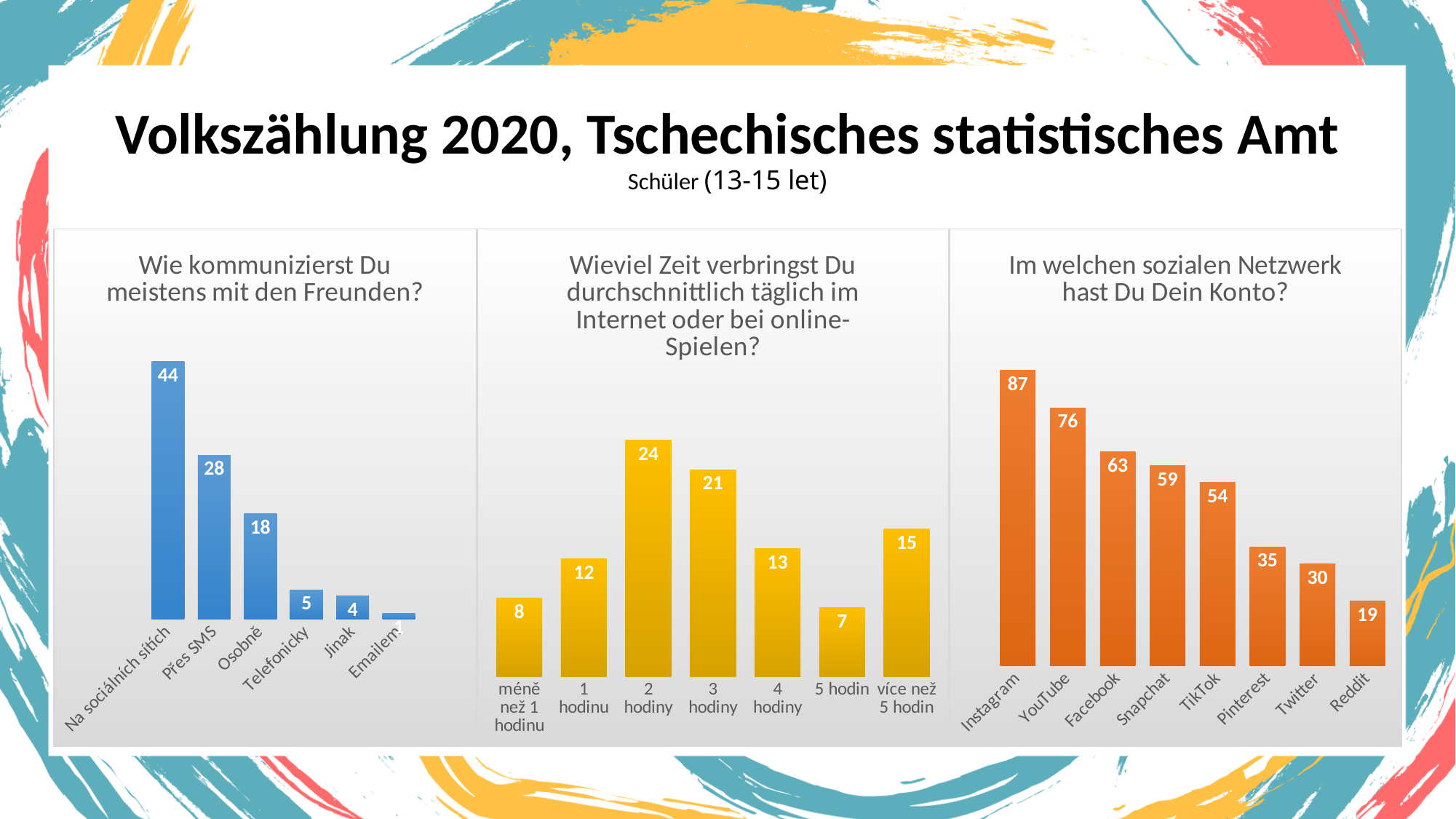
What kind of chart is the right chart 'Im welchen sozialen Netzwerk hast Du Dein Konto?'? bar chart In the right chart 'Im welchen sozialen Netzwerk hast Du Dein Konto?', what is the value for TikTok? 54 In the middle chart 'Wieviel Zeit verbringst Du durchschnittlich täglich im Internet oder bei online-Spielen?', how many categories are shown? 7 In the middle chart 'Wieviel Zeit verbringst Du durchschnittlich täglich im Internet oder bei online-Spielen?', what is the value for 2 hodiny? 24 In the left chart 'Wie kommunizierst Du meistens mit den Freunden?', what is the value for Přes SMS? 28 In the middle chart 'Wieviel Zeit verbringst Du durchschnittlich täglich im Internet oder bei online-Spielen?', which is larger: 4 hodiny or více než 5 hodin? více než 5 hodin In the left chart 'Wie kommunizierst Du meistens mit den Freunden?', which category has the highest value? Na sociálních sítích In the left chart 'Wie kommunizierst Du meistens mit den Freunden?', how many categories are shown? 6 In the right chart 'Im welchen sozialen Netzwerk hast Du Dein Konto?', do the values rise or fall from left to right? fall In the middle chart 'Wieviel Zeit verbringst Du durchschnittlich täglich im Internet oder bei online-Spielen?', which category has the lowest value? 5 hodin In the left chart 'Wie kommunizierst Du meistens mit den Freunden?', what is the difference between Na sociálních sítích and Osobně? 26 In the right chart 'Im welchen sozialen Netzwerk hast Du Dein Konto?', what is the difference between Instagram and YouTube? 11